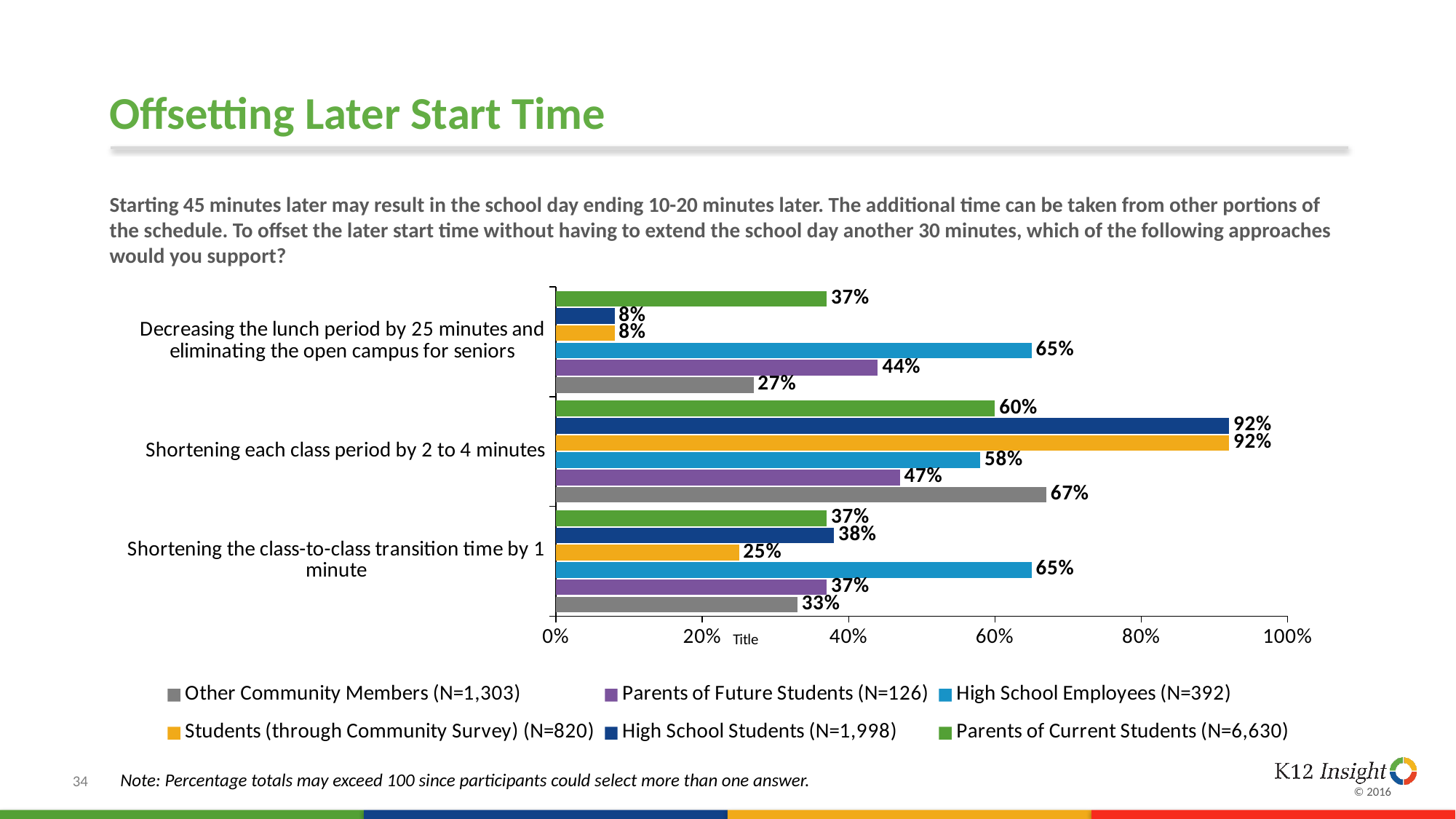
Is the value for Parents of Future Students on decreasing the lunch period greater or less than 40%? greater Which group has the lowest support for shortening each class period by 2 to 4 minutes? Parents of Future Students How many approaches (categories) are shown on the chart? 3 Which group has the highest support for shortening the class-to-class transition time by 1 minute? High School Employees What percentage of Other Community Members support decreasing the lunch period by 25 minutes and eliminating the open campus for seniors? 27% What percentage of Students (through Community Survey) support shortening the class-to-class transition time by 1 minute? 25% How many series does the legend list? 6 What kind of chart is shown on the slide? Bar chart What percentage of High School Employees support shortening each class period by 2 to 4 minutes? 58% Which is larger: Parents of Current Students' support for shortening each class period or Other Community Members' support for the same approach? Other Community Members What is the sample size (N) shown in the legend for Parents of Current Students? N=6,630 What is the difference between High School Students' support for shortening each class period (92%) and their support for decreasing the lunch period (8%)? 84 percentage points